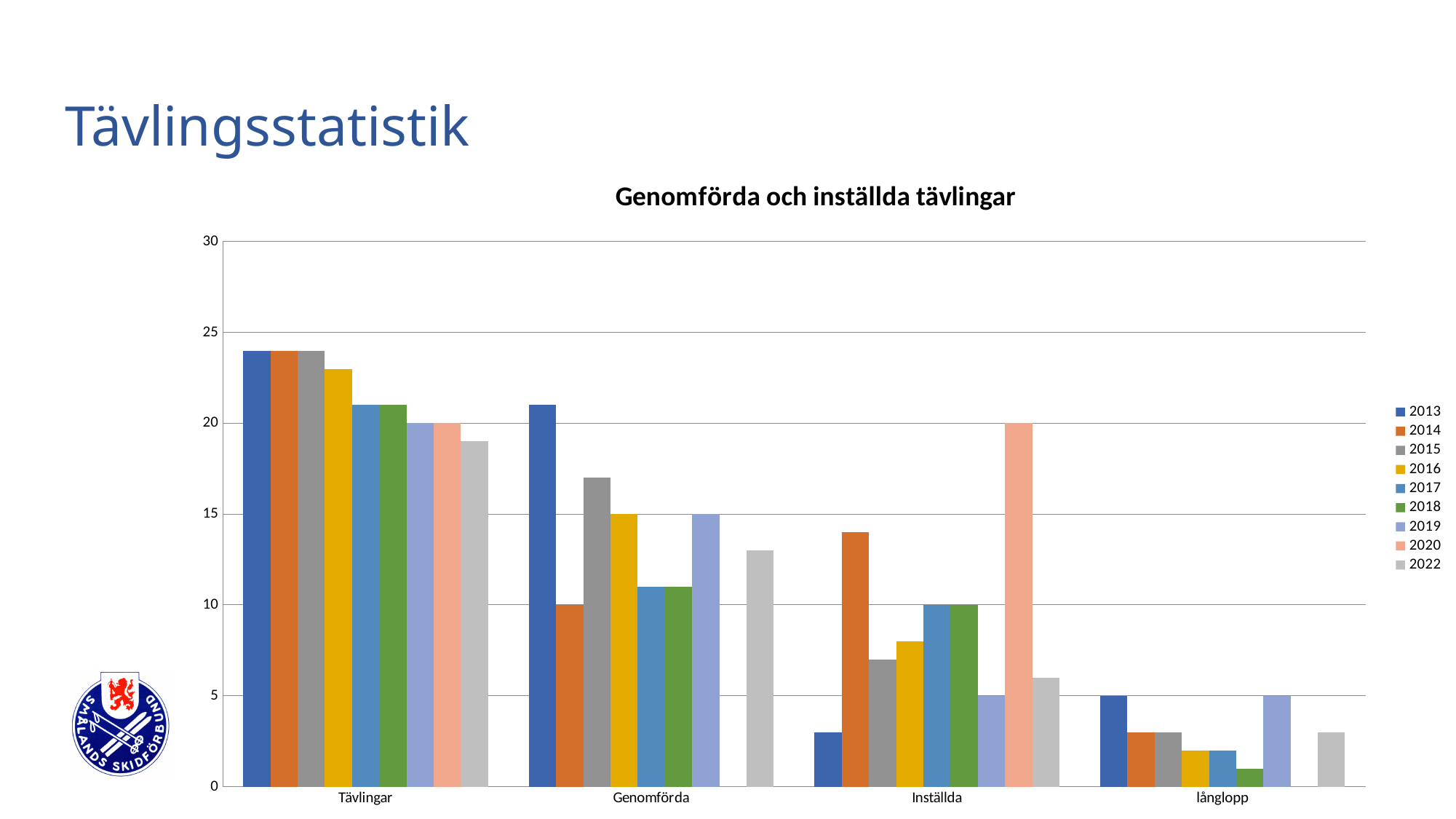
What is the value for 2020 in the Inställda category? 20 How many series does the legend list? 9 Which year has the lowest value in the långlopp category? 2020 In the Genomförda category, which is larger, the value for 2013 or the value for 2014? 2013 Which year has the highest value in the Inställda category? 2020 How many categories are shown on the x axis? 4 What type of chart is shown on the slide? bar chart What is the value for 2014 in the Genomförda category? 10 What is the title of the chart? Genomförda och inställda tävlingar Is the value for 2013 in the Tävlingar category greater or less than 20? greater What is the value for 2019 in the långlopp category? 5 Is the value for 2022 in the Genomförda category greater or less than 10? greater